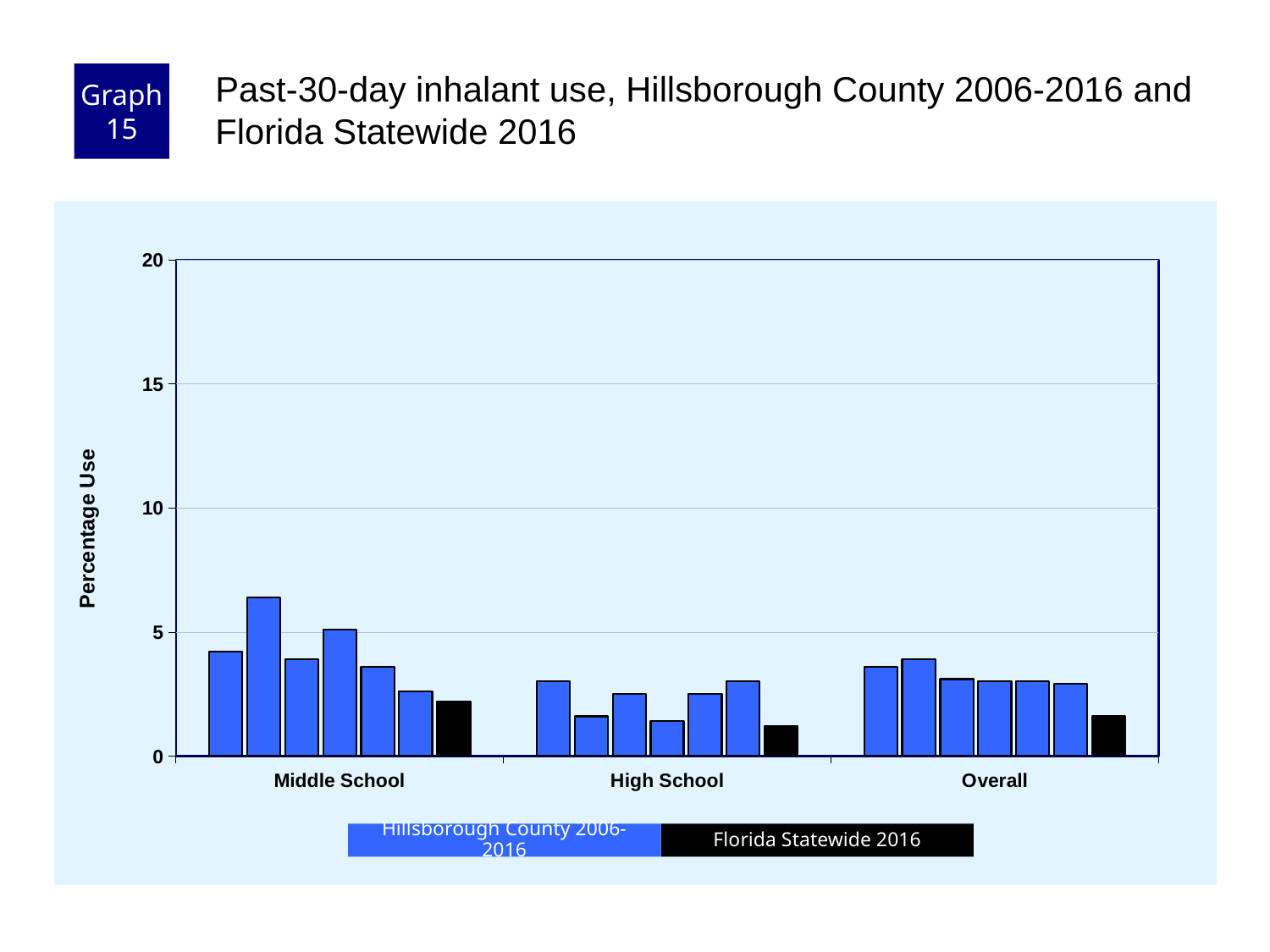
What is the label on the y axis of the chart? Percentage Use Which x-axis group contains the tallest bar in the chart? Middle School Is the Florida Statewide 2016 bar larger for Middle School or for High School? Middle School Is the tallest bar in the Middle School group greater or less than 5? greater How many series does the chart legend list? 2 Are any bars in the chart greater than 10? no What kind of chart is shown on the slide? bar chart Is the Florida Statewide 2016 bar for High School greater or less than 5? less How many bars are shown in the High School group? 7 Which colour represents Florida Statewide 2016 in the chart? black How many categories are shown on the x axis of the chart? 3